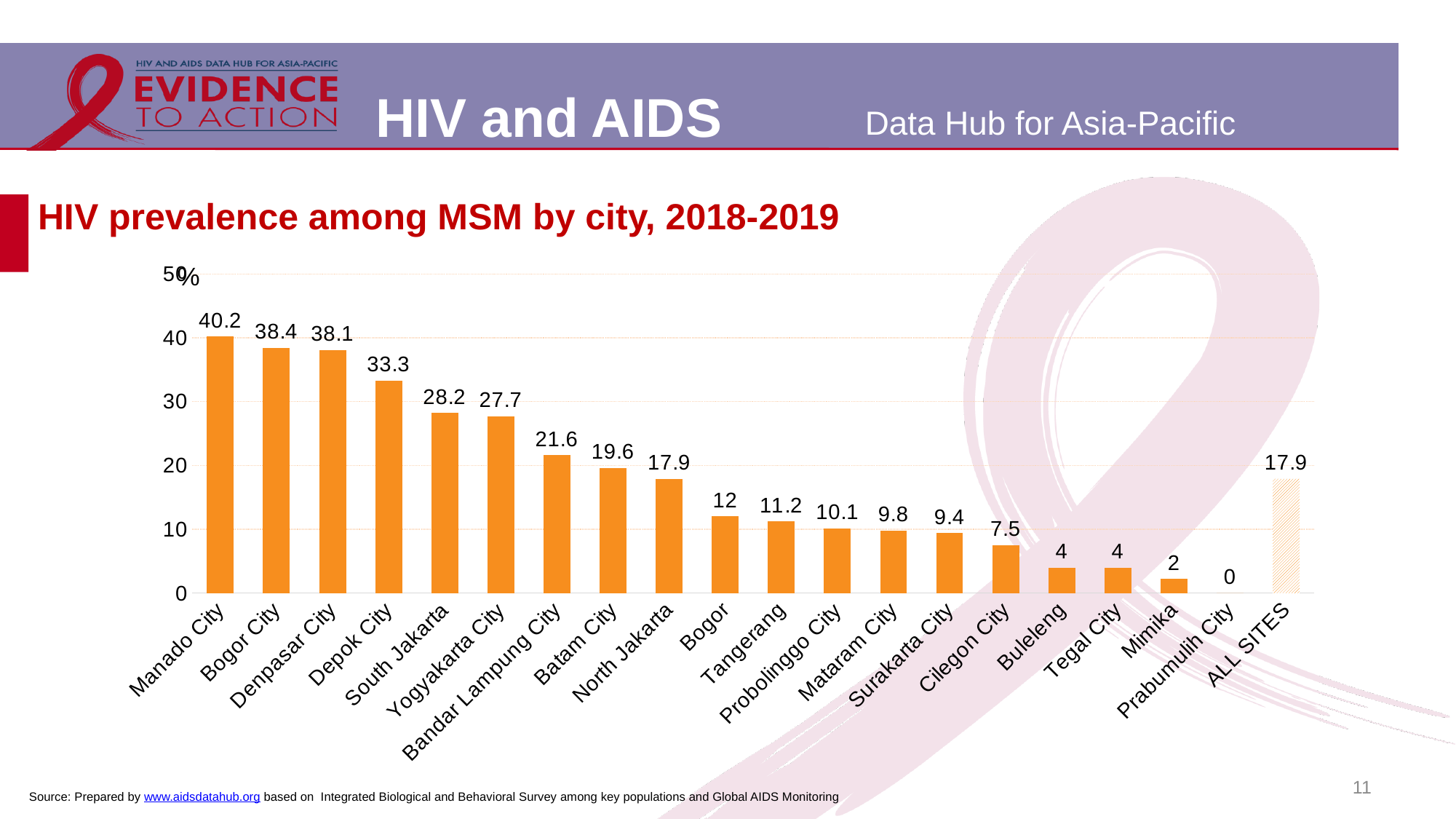
Which city has the lowest HIV prevalence among MSM? Prabumulih City What is the value shown for ALL SITES? 17.9 Do the city values rise or fall from left to right across the chart (excluding ALL SITES)? Fall What is the HIV prevalence among MSM in Manado City? 40.2 How many bars are shown on the chart, including ALL SITES? 20 What is the difference between the values for Manado City and Bogor City? 1.8 Which city has the highest HIV prevalence among MSM? Manado City What is the difference between the values for Depok City and South Jakarta? 5.1 Which has a higher HIV prevalence among MSM, Batam City or Bogor? Batam City What is the title of the chart? HIV prevalence among MSM by city, 2018-2019 What is the HIV prevalence among MSM in Bandar Lampung City? 21.6 What kind of chart is shown on the slide? Bar chart